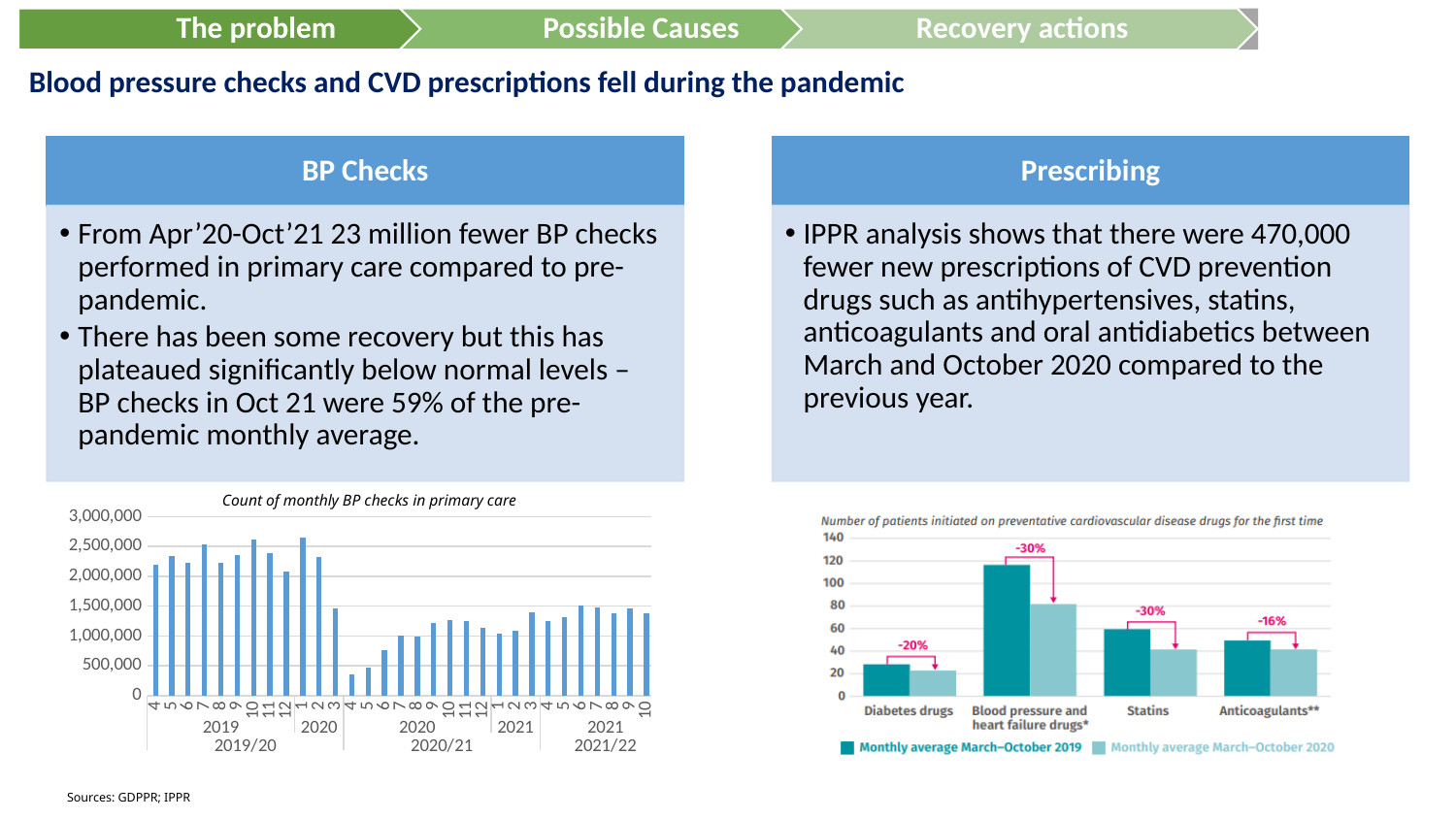
In the right chart, is the March–October 2019 value for Diabetes drugs greater or less than 40? less In the right chart, what percentage change is labelled above the Diabetes drugs bars? -20% In the right chart, what percentage change is labelled above the Anticoagulants bars? -16% In the right chart (patients initiated on preventative cardiovascular disease drugs), how many drug categories are shown on the x axis? 4 In the left chart (Count of monthly BP checks in primary care), is the value for April 2020 greater or less than 500,000? less In the left chart (Count of monthly BP checks in primary care), do the values rise or fall from January 2020 to April 2020? fall In the right chart, which drug category has the highest monthly average for March–October 2019? Blood pressure and heart failure drugs In the left chart (Count of monthly BP checks in primary care), which month has the lowest bar? April 2020 What kind of chart is the right chart showing the number of patients initiated on preventative cardiovascular disease drugs? bar chart In the right chart, is the March–October 2019 value for Blood pressure and heart failure drugs greater or less than 100? greater What kind of chart is the left chart titled 'Count of monthly BP checks in primary care'? bar chart In the right chart (patients initiated on preventative cardiovascular disease drugs), how many series does the legend list? 2